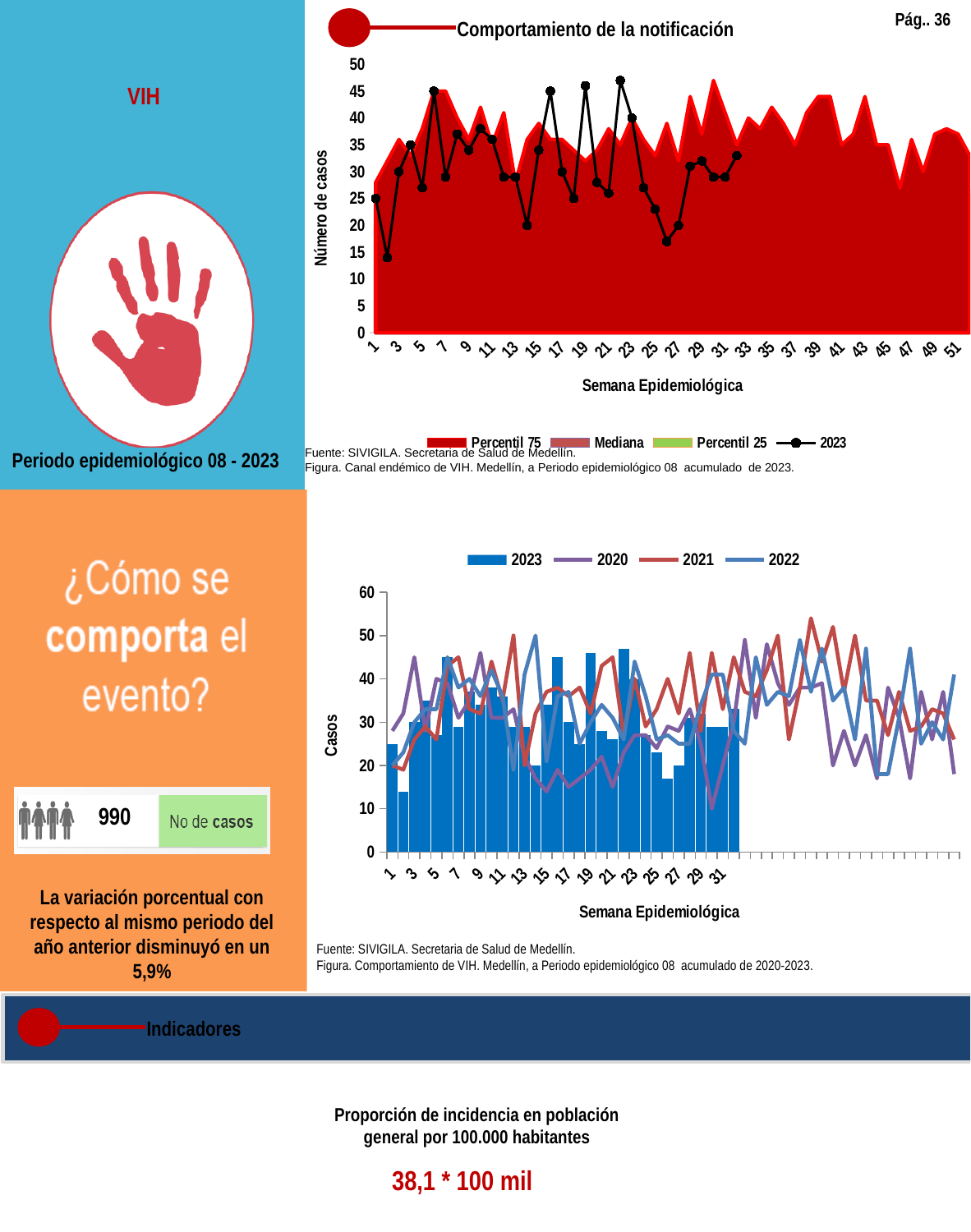
What is the title of the top chart? Comportamiento de la notificación In the bottom chart, which is larger for 2023: the bar at week 2 or the bar at week 22? week 22 In the top chart, is the 2023 value at week 22 greater or less than 40? greater In the bottom chart, is the 2023 bar at week 2 greater or less than 20? less In the top chart, which is larger for the 2023 line: week 2 or week 19? week 19 In the bottom chart, which year is shown as bars rather than a line? 2023 In the bottom chart, how many series does the legend list? 4 In the bottom chart, is the 2023 bar at week 22 greater or less than 40? greater What kind of chart is the bottom chart? Bar chart combined with line series In the top chart, how many series does the legend list? 4